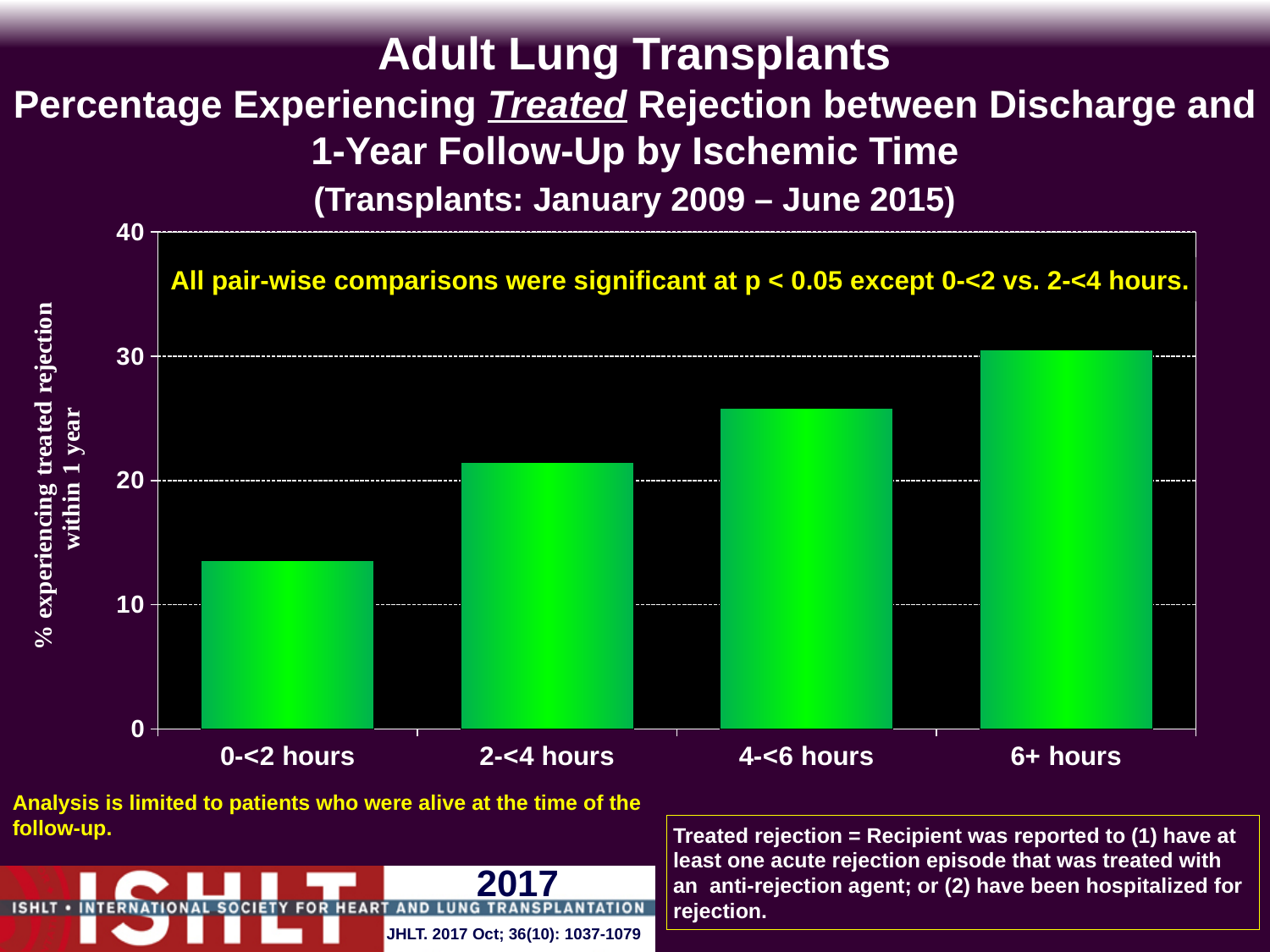
What is the label on the y axis of the chart? % experiencing treated rejection within 1 year Which is larger, the value for 4-<6 hours or the value for 2-<4 hours? 4-<6 hours What kind of chart is shown on the slide? bar chart Is the value for 4-<6 hours greater or less than 30? less Is the value for 0-<2 hours greater or less than 10? greater How many ischemic time categories are shown on the x axis? 4 Is the value for 4-<6 hours greater or less than 20? greater Which ischemic time category has the highest percentage experiencing treated rejection? 6+ hours Do the values rise or fall as ischemic time increases along the x axis? rise Which ischemic time category has the lowest percentage experiencing treated rejection? 0-<2 hours